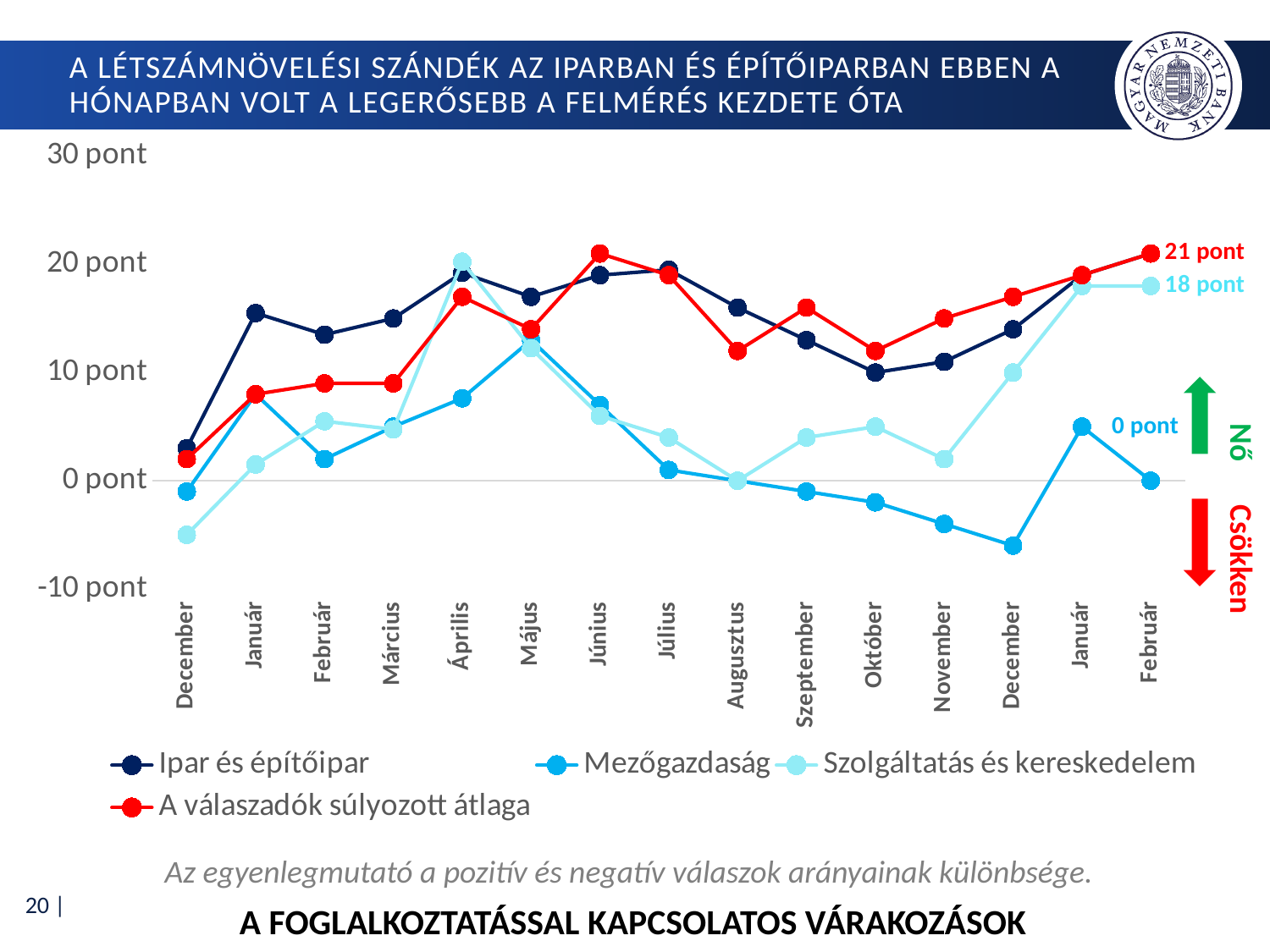
What kind of chart is shown on the slide? line chart What is the value of 'A válaszadók súlyozott átlaga' in the final Február? 21 pont Is the value for 'Mezőgazdaság' in the second December greater or less than 0 pont? less How many months are plotted along the x axis? 15 In the final Február, what is the difference between 'A válaszadók súlyozott átlaga' and 'Szolgáltatás és kereskedelem'? 3 pont What is the value of 'Szolgáltatás és kereskedelem' in the final Február? 18 pont How many series does the legend list? 4 What is the value of 'Mezőgazdaság' in the final Február? 0 pont Is the value for 'Ipar és építőipar' in the first Január greater or less than 10 pont? greater Does the 'Mezőgazdaság' line rise or fall from Május to the second December? fall In the final Február, which is larger: 'A válaszadók súlyozott átlaga' or 'Mezőgazdaság'? A válaszadók súlyozott átlaga Which series has the lowest value in the first December? Szolgáltatás és kereskedelem